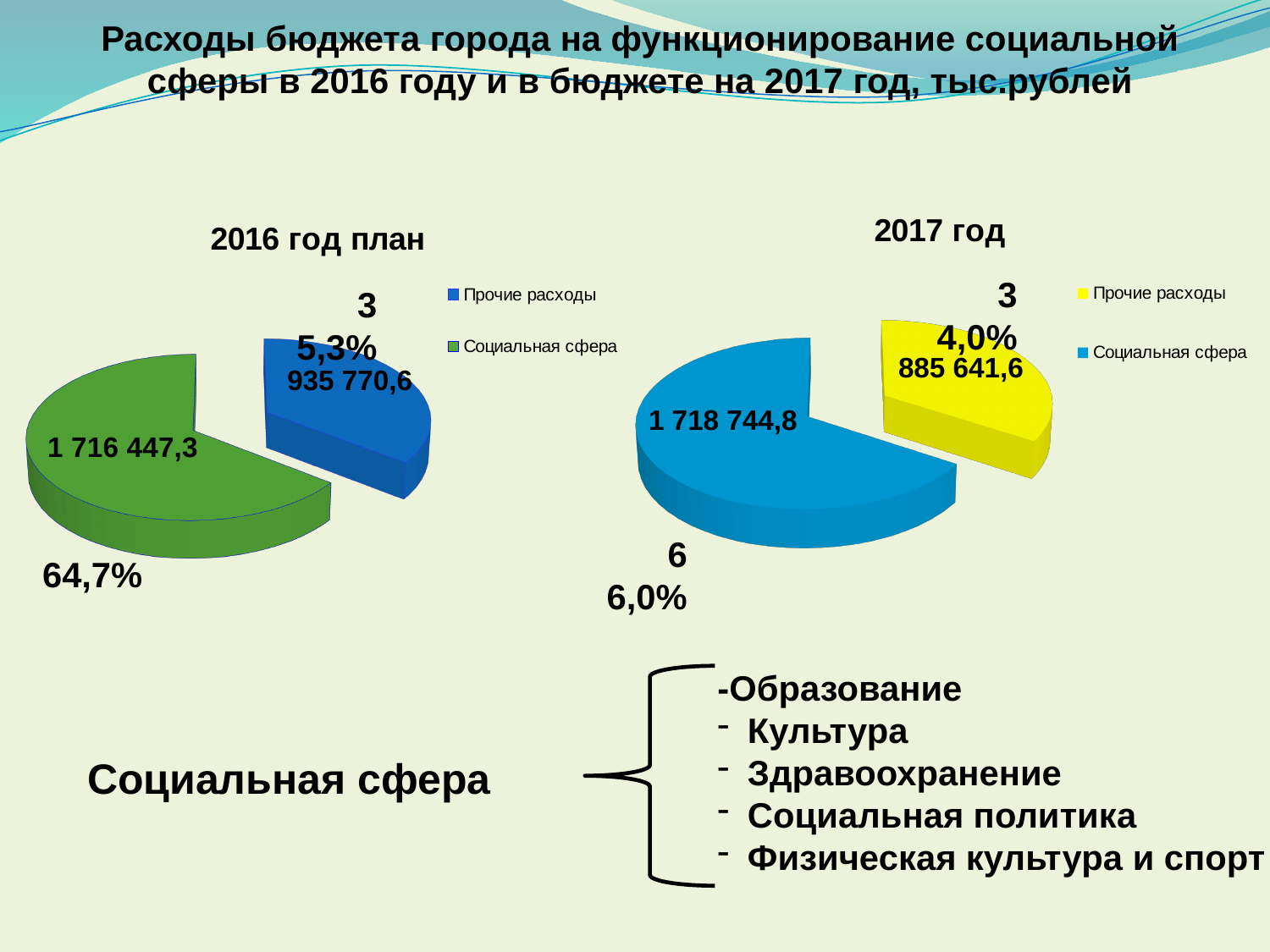
In the "2017 год" chart, what colour is the Социальная сфера slice? Blue In the "2016 год план" chart, what is the difference between Социальная сфера and Прочие расходы? 780 676,7 What type of chart is used for the "2016 год план" chart? Pie chart In the "2016 год план" chart, what share of the pie does Социальная сфера take? 64,7% In the "2017 год" chart, what is the value for Прочие расходы? 885 641,6 In the "2017 год" chart, what is the value for Социальная сфера? 1 718 744,8 In the "2016 год план" chart, what is the value for Социальная сфера? 1 716 447,3 In the "2016 год план" chart, which category has the largest slice? Социальная сфера In the "2016 год план" chart, what is the value for Прочие расходы? 935 770,6 In the "2017 год" chart, what is the difference between Социальная сфера and Прочие расходы? 833 103,2 How many entries does the legend of the "2017 год" chart list? 2 In the "2017 год" chart, which category has the smallest slice? Прочие расходы